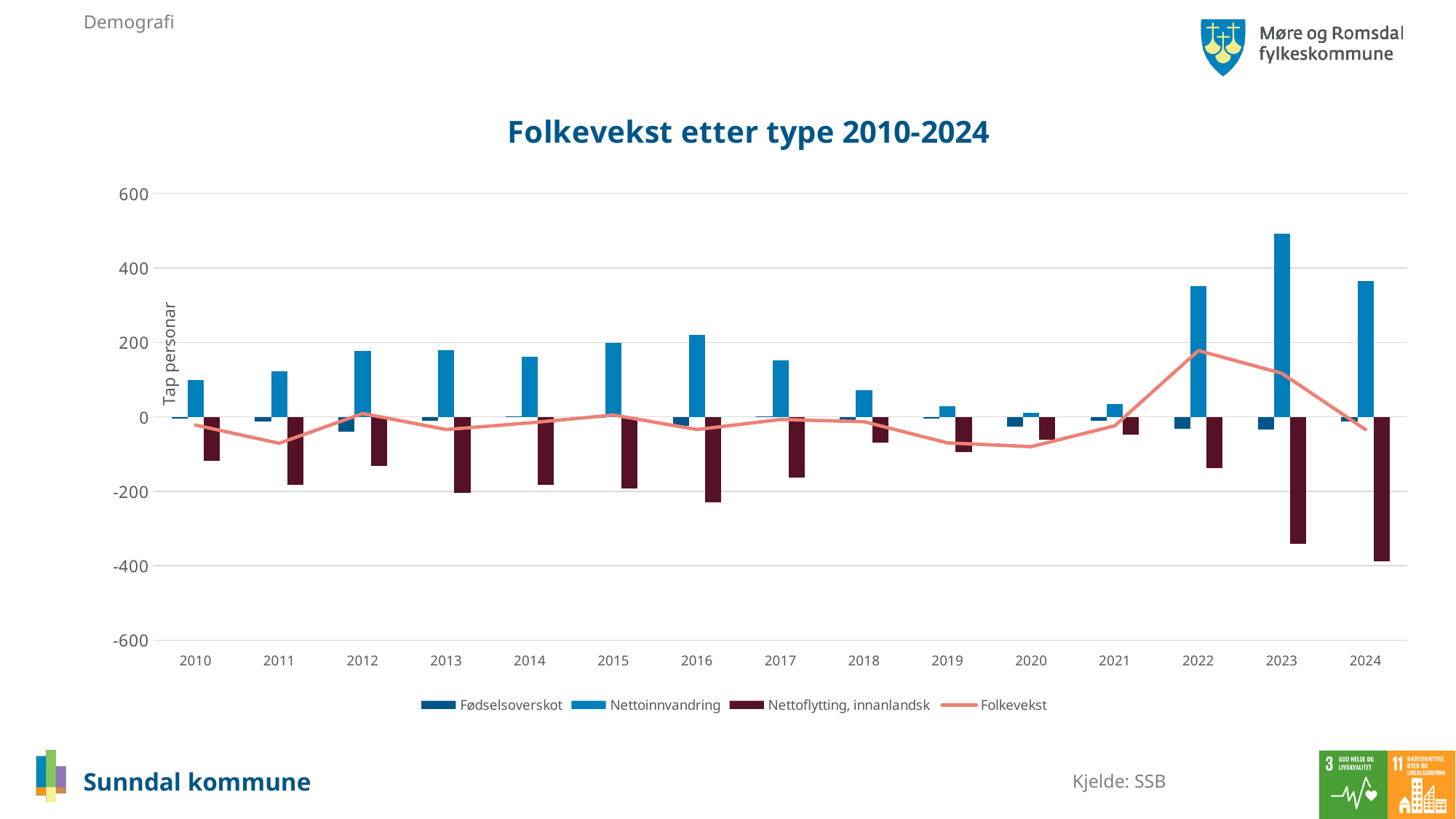
What kind of chart is shown on the slide? Combined bar and line chart Does the Folkevekst line rise or fall from 2022 to 2024? fall How many years are shown on the x axis? 15 What is the title of the chart? Folkevekst etter type 2010-2024 How many series does the legend list? 4 In which year does the Folkevekst line reach its highest point? 2022 Which year has the larger Nettoinnvandring value, 2010 or 2015? 2015 Is the Nettoinnvandring value for 2023 greater or less than 400? greater In which year is the Nettoinnvandring bar lowest? 2020 Is the Nettoflytting, innanlandsk value for 2024 greater or less than -200? less In which year is the Nettoflytting, innanlandsk bar most negative? 2024 In which year is the Nettoinnvandring bar highest? 2023